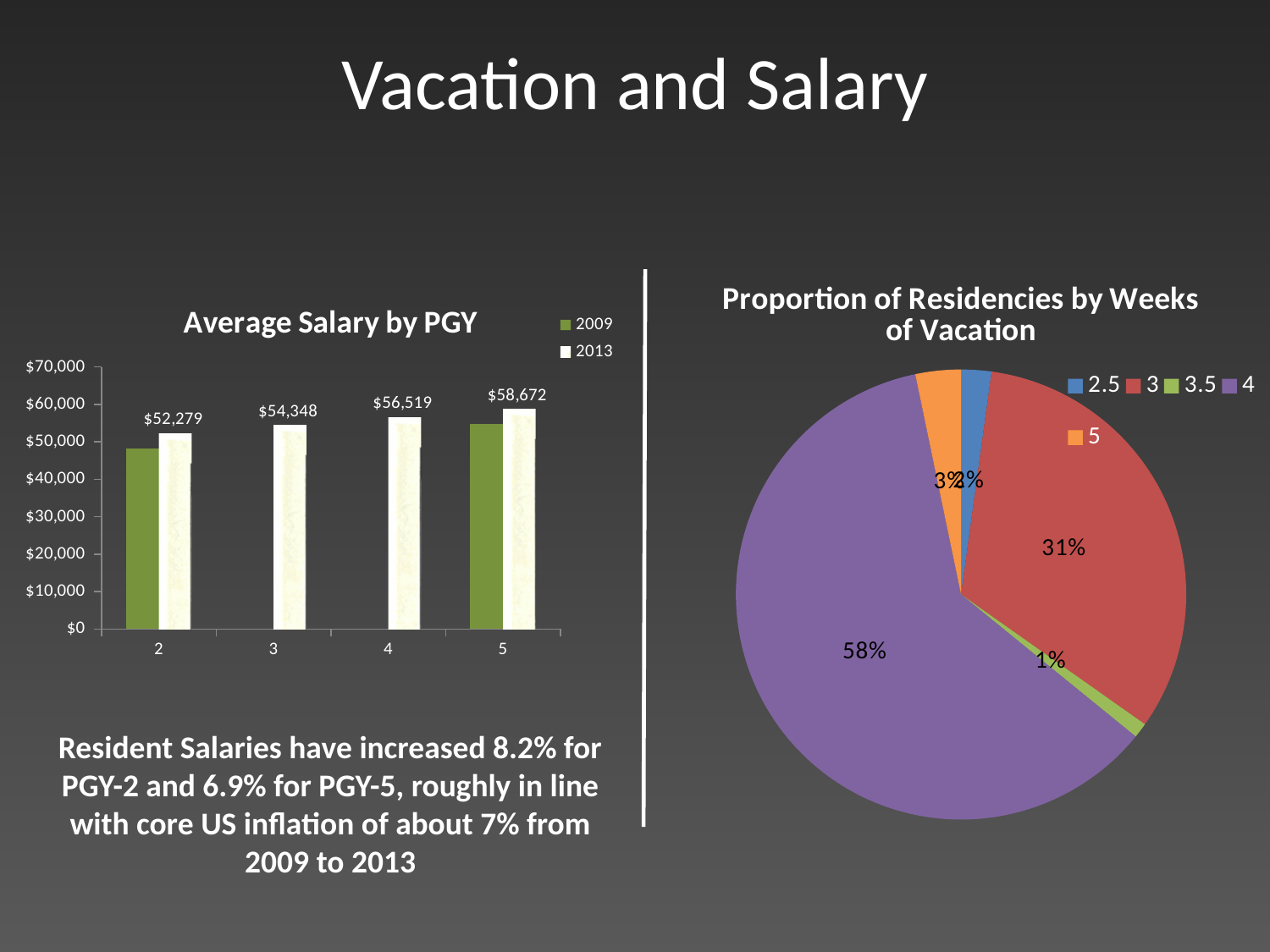
How many PGY categories are shown on the x axis of the "Average Salary by PGY" chart? 4 In the "Proportion of Residencies by Weeks of Vacation" pie chart, what share of residencies offer 4 weeks of vacation? 58% In the "Average Salary by PGY" chart, what is the 2013 average salary for PGY 5? $58,672 What kind of chart is the "Average Salary by PGY" chart on the left? bar chart In the "Average Salary by PGY" chart, what is the 2013 average salary for PGY 2? $52,279 In the "Average Salary by PGY" chart, is the 2009 value for PGY 2 greater or less than $40,000? greater What kind of chart is the "Proportion of Residencies by Weeks of Vacation" chart on the right? pie chart In the "Average Salary by PGY" chart, what is the difference between the 2013 salaries for PGY 5 and PGY 2? $6,393 How many series does the legend of the "Average Salary by PGY" chart list? 2 In the "Average Salary by PGY" chart, do the 2013 salaries rise or fall as PGY increases from 2 to 5? rise In the "Proportion of Residencies by Weeks of Vacation" pie chart, which weeks-of-vacation category has the largest slice? 4 In the "Average Salary by PGY" chart, what is the difference between the 2013 salaries for PGY 4 and PGY 3? $2,171